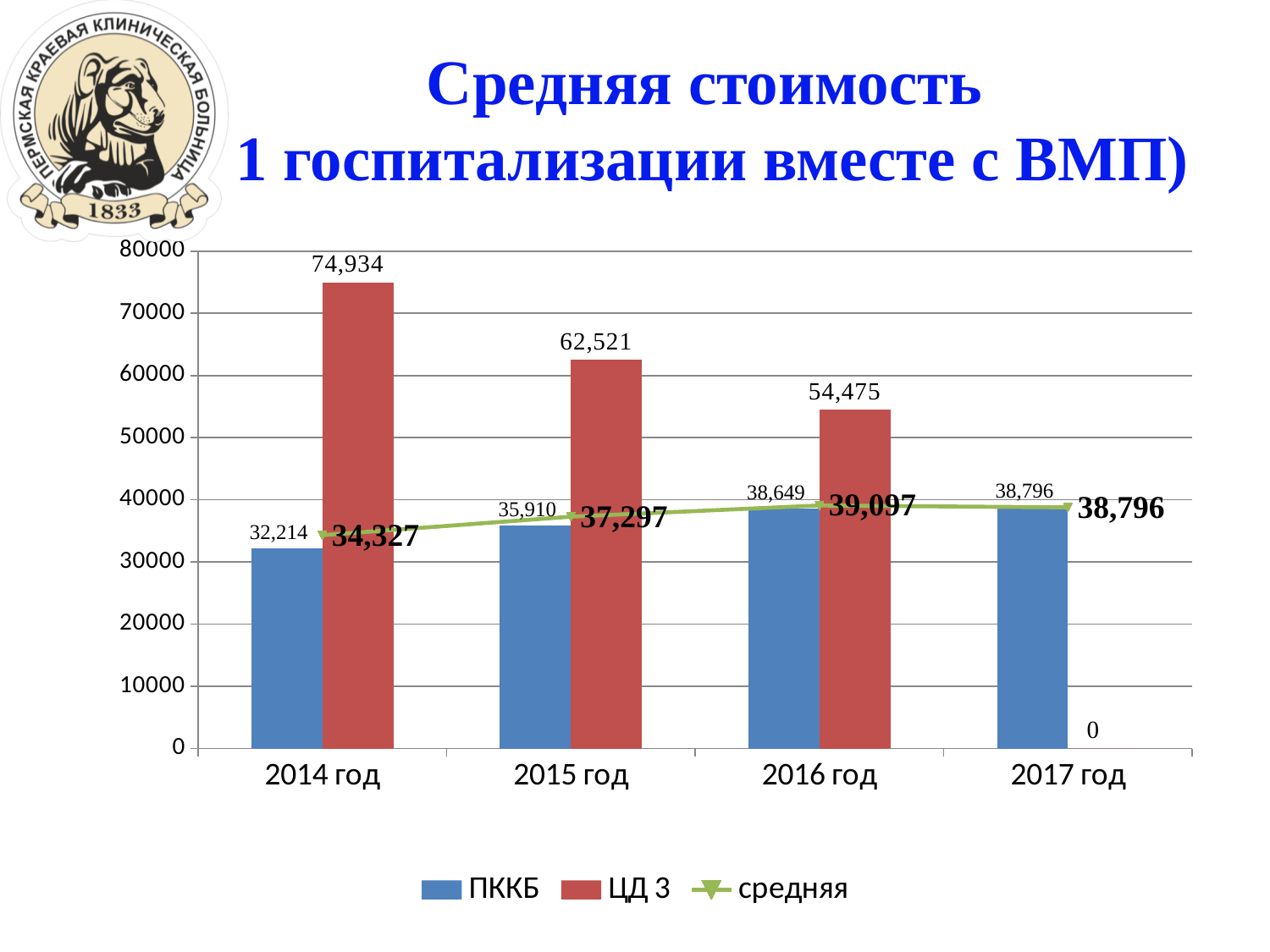
What is the value for ЦД 3 in 2015 год? 62,521 What is the value for ЦД 3 in 2017 год? 0 Is the ЦД 3 value for 2016 год greater or less than 50000? greater Which is larger in 2016 год, ПККБ or ЦД 3? ЦД 3 How many series does the legend list? 3 How many years are shown on the x axis? 4 In which year is the ЦД 3 value highest? 2014 год What is the value of the средняя line in 2016 год? 39,097 In which year is the ПККБ value lowest? 2014 год What is the difference between the ЦД 3 value and the ПККБ value in 2014 год? 42,720 Does the ЦД 3 value rise or fall from 2014 год to 2016 год? fall What is the value for ПККБ in 2014 год? 32,214